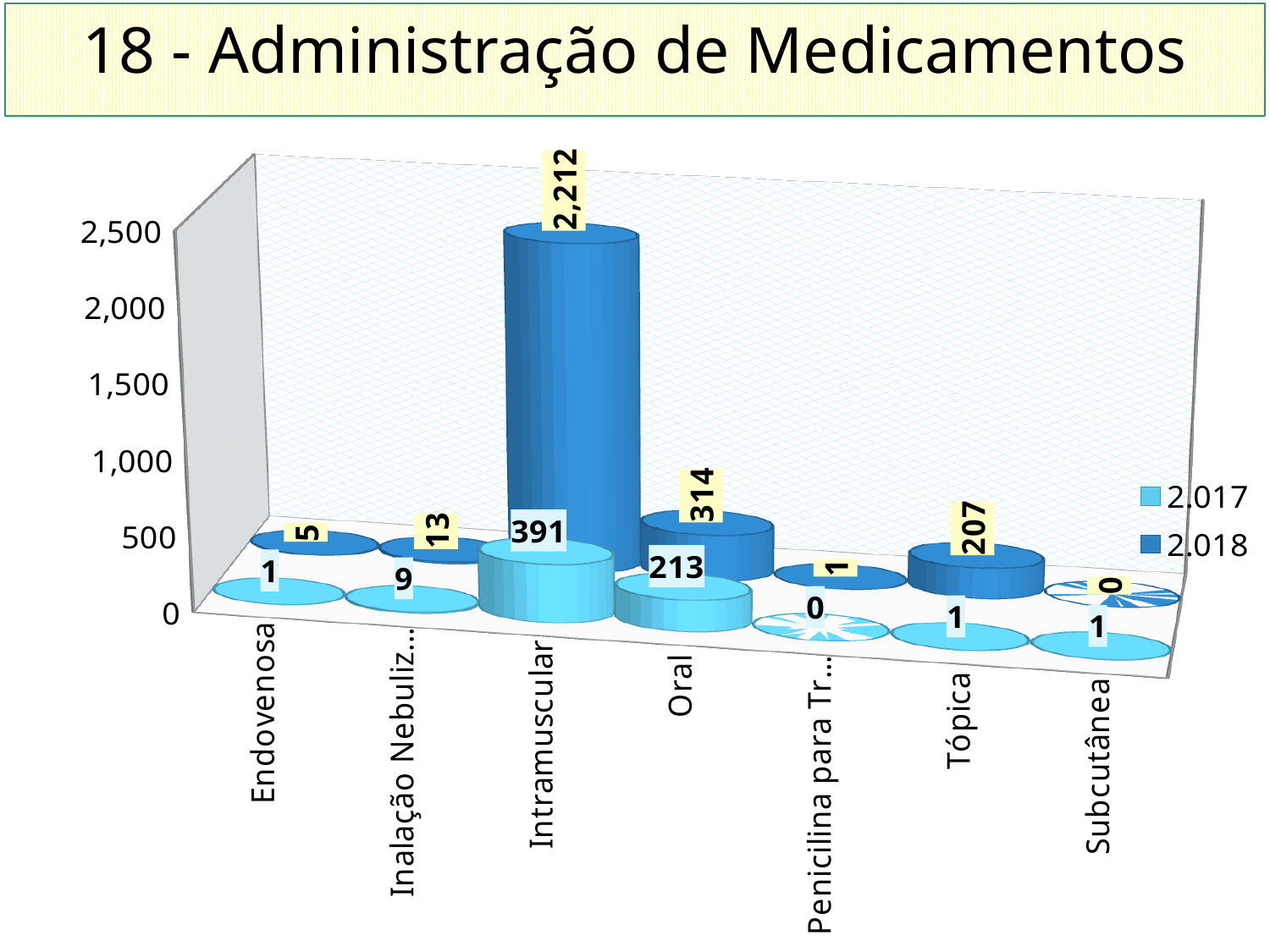
Which category has the highest value in the 2.017 series? Intramuscular Which category has the highest value in the 2.018 series? Intramuscular Which is larger for Tópica: the 2.017 value or the 2.018 value? 2.018 How many series does the legend list? 2 How many categories are shown on the x axis? 7 What is the value for Tópica in the 2.018 series? 207 What kind of chart is shown on the slide? Bar chart What is the difference between the 2.018 and 2.017 values for Oral? 101 What is the value for Intramuscular in the 2.018 series? 2,212 What is the value for Oral in the 2.017 series? 213 What is the value for Endovenosa in the 2.018 series? 5 What is the difference between the 2.018 and 2.017 values for Intramuscular? 1,821